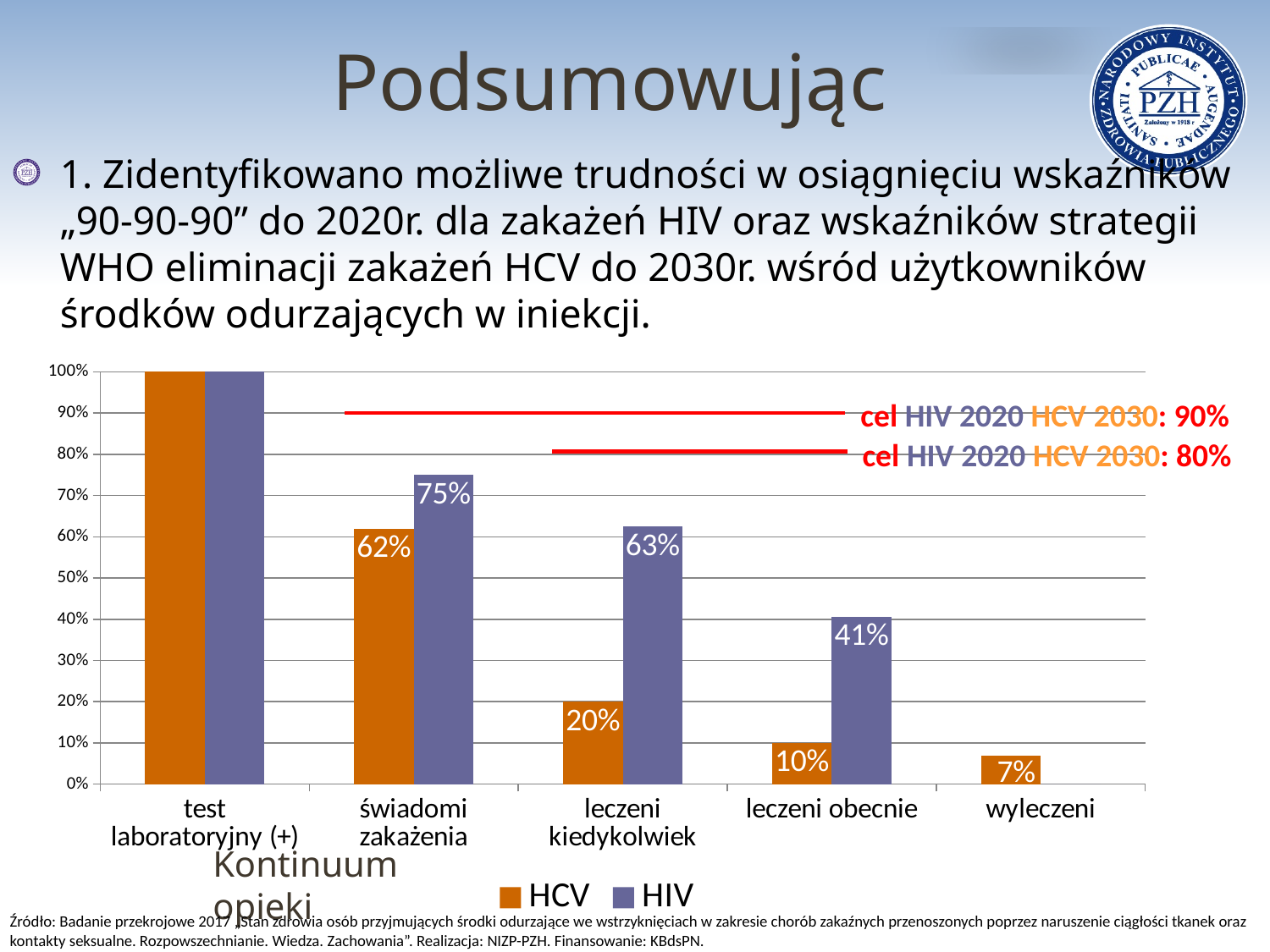
What is the HIV value for "świadomi zakażenia"? 75% How many categories are shown on the x axis? 5 What is the HCV value for "wyleczeni"? 7% What is the HCV value for "świadomi zakażenia"? 62% How many series does the legend list? 2 Do the HCV values rise or fall from left to right along the x axis? fall What is the HCV value for "leczeni obecnie"? 10% What is the HIV value for "leczeni kiedykolwiek"? 63% Is the HIV value for "leczeni obecnie" greater or less than 50%? less What is the difference between the HIV and HCV values for "leczeni kiedykolwiek"? 43% Which is larger for "leczeni obecnie": the HCV value or the HIV value? HIV What kind of chart is shown on the slide? bar chart